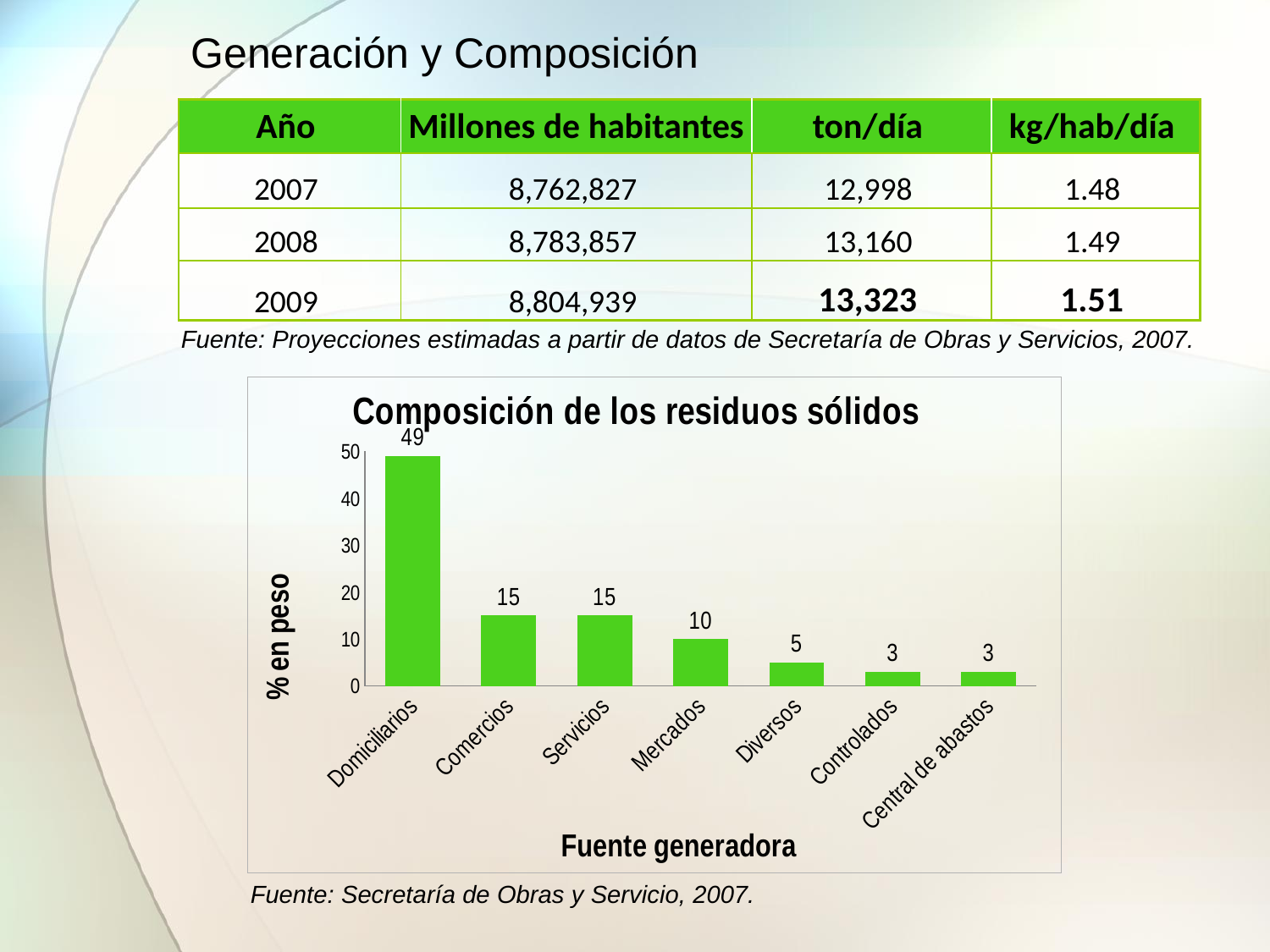
What is the title of the chart? Composición de los residuos sólidos What is the value for Domiciliarios in the chart? 49 How many categories are shown in the chart? 7 Which category has the highest value in the chart? Domiciliarios What kind of chart is shown on the slide? bar chart What is the label of the x axis of the chart? Fuente generadora What is the value for Mercados in the chart? 10 What is the difference between the values for Domiciliarios and Comercios? 34 What is the value for Diversos in the chart? 5 Which is larger, the value for Servicios or the value for Mercados? Servicios Is the value for Domiciliarios greater or less than 40? greater What is the difference between the values for Mercados and Diversos? 5